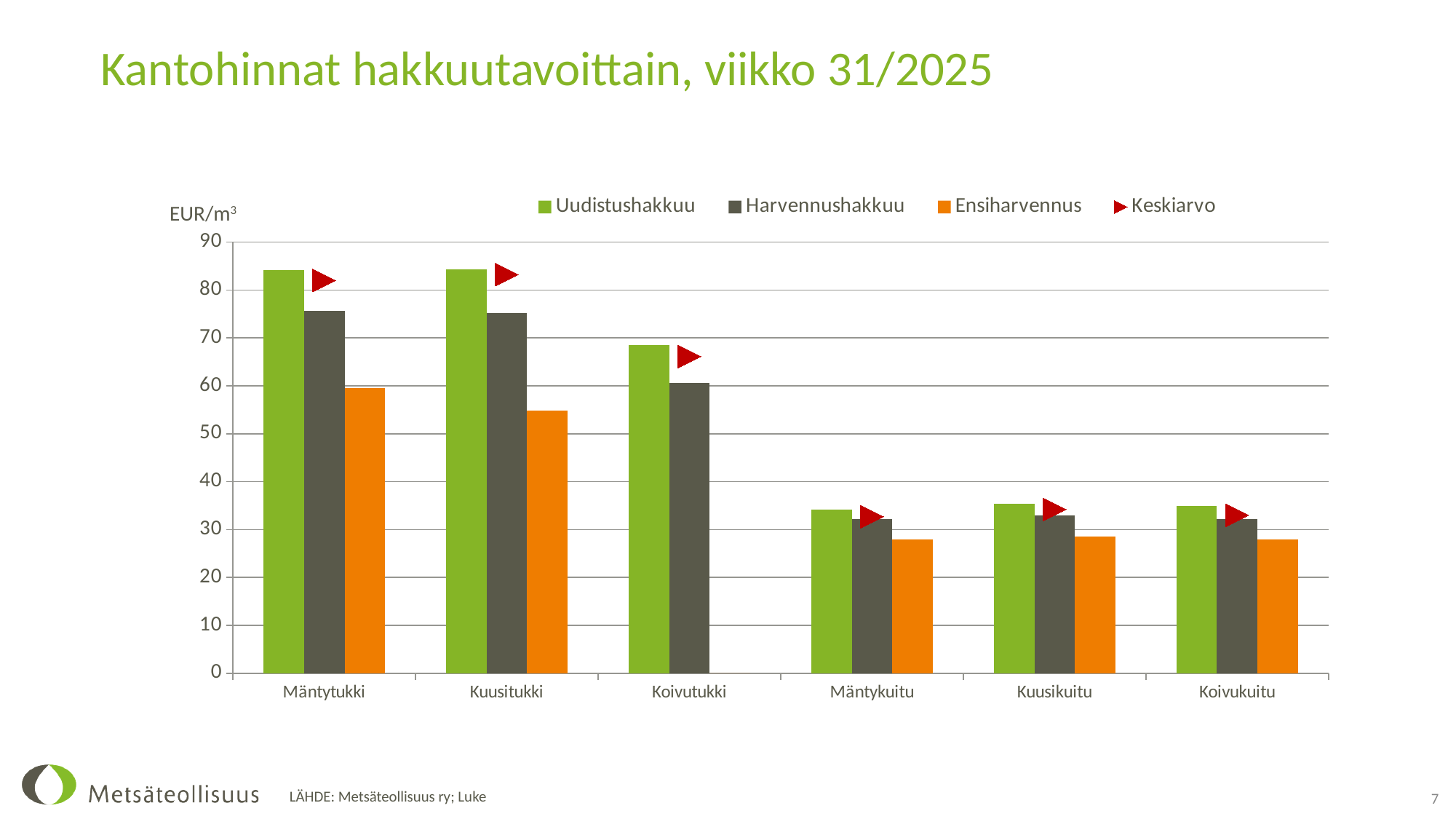
Which category has the highest Ensiharvennus value? Mäntytukki Which is larger, the Uudistushakkuu value for Kuusitukki or for Koivutukki? Kuusitukki Is the Uudistushakkuu value for Mäntytukki greater or less than 80? greater What unit is shown on the y axis? EUR/m³ How many series does the legend list? 4 Which category has no Ensiharvennus bar? Koivutukki Is the Uudistushakkuu value for Koivutukki greater or less than 70? less Is the Ensiharvennus value for Kuusitukki greater or less than 60? less How many categories are shown on the x axis? 6 What kind of chart is shown on the slide? bar chart